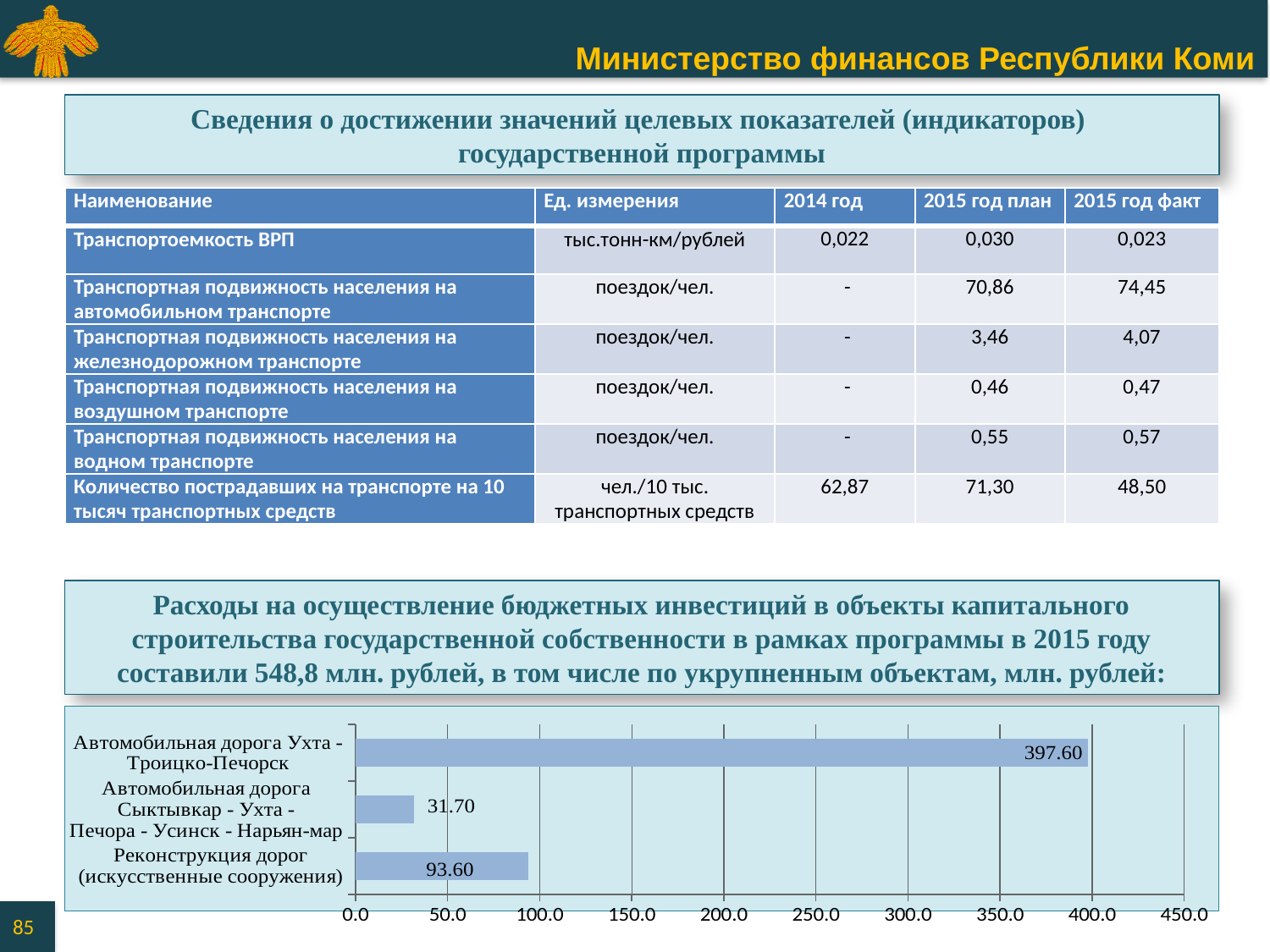
What is the maximum value shown on the horizontal axis of the bar chart? 450.0 In the bar chart, which is larger: the value for "Реконструкция дорог (искусственные сооружения)" or the value for "Автомобильная дорога Сыктывкар - Ухта - Печора - Усинск - Нарьян-мар"? Реконструкция дорог (искусственные сооружения) What is the value for "Автомобильная дорога Сыктывкар - Ухта - Печора - Усинск - Нарьян-мар" in the bar chart? 31.70 Which category has the highest value in the bar chart? Автомобильная дорога Ухта - Троицко-Печорск How many categories does the bar chart show? 3 In the bar chart, is the value for "Автомобильная дорога Ухта - Троицко-Печорск" greater or less than 350.0? greater What is the difference between the values for "Реконструкция дорог (искусственные сооружения)" and "Автомобильная дорога Сыктывкар - Ухта - Печора - Усинск - Нарьян-мар" in the bar chart? 61.90 What is the value for "Реконструкция дорог (искусственные сооружения)" in the bar chart? 93.60 What is the value for "Автомобильная дорога Ухта - Троицко-Печорск" in the bar chart? 397.60 Which category has the lowest value in the bar chart? Автомобильная дорога Сыктывкар - Ухта - Печора - Усинск - Нарьян-мар What kind of chart is shown at the bottom of the slide? bar chart What is the difference between the values for "Автомобильная дорога Ухта - Троицко-Печорск" and "Реконструкция дорог (искусственные сооружения)" in the bar chart? 304.00